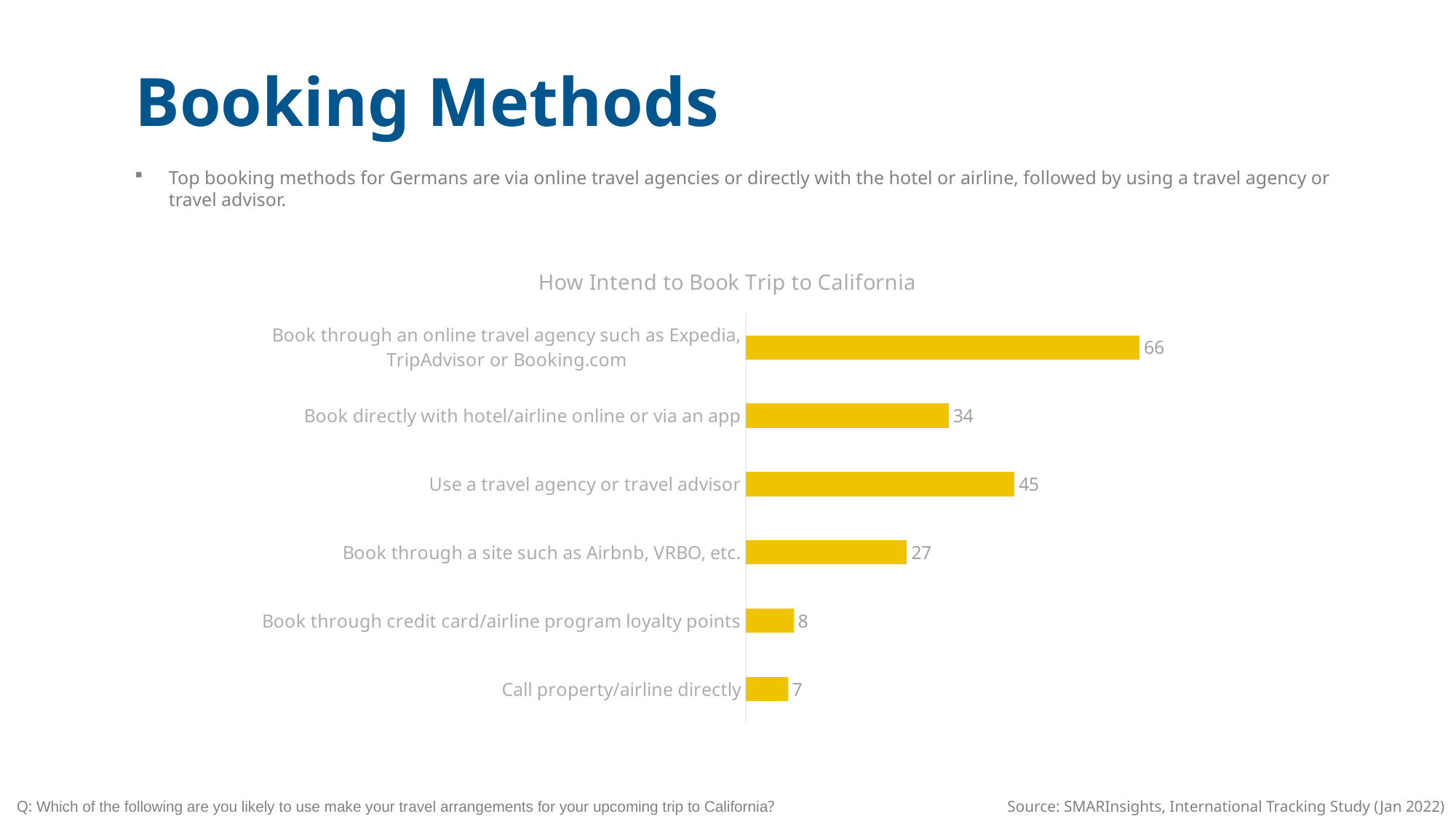
What is the title of the chart? How Intend to Book Trip to California Which booking method has the lowest value? Call property/airline directly What is the value for "Book through an online travel agency such as Expedia, TripAdvisor or Booking.com"? 66 What colour are the bars in the chart? Yellow What is the value for "Call property/airline directly"? 7 How many booking methods are shown in the chart? 6 Which is larger: the value for "Use a travel agency or travel advisor" or "Book directly with hotel/airline online or via an app"? Use a travel agency or travel advisor What is the value for "Book through a site such as Airbnb, VRBO, etc."? 27 What kind of chart is shown on the slide? Bar chart What is the value for "Use a travel agency or travel advisor"? 45 Which booking method has the highest value? Book through an online travel agency such as Expedia, TripAdvisor or Booking.com What is the difference between the values for "Book through an online travel agency such as Expedia, TripAdvisor or Booking.com" and "Book directly with hotel/airline online or via an app"? 32